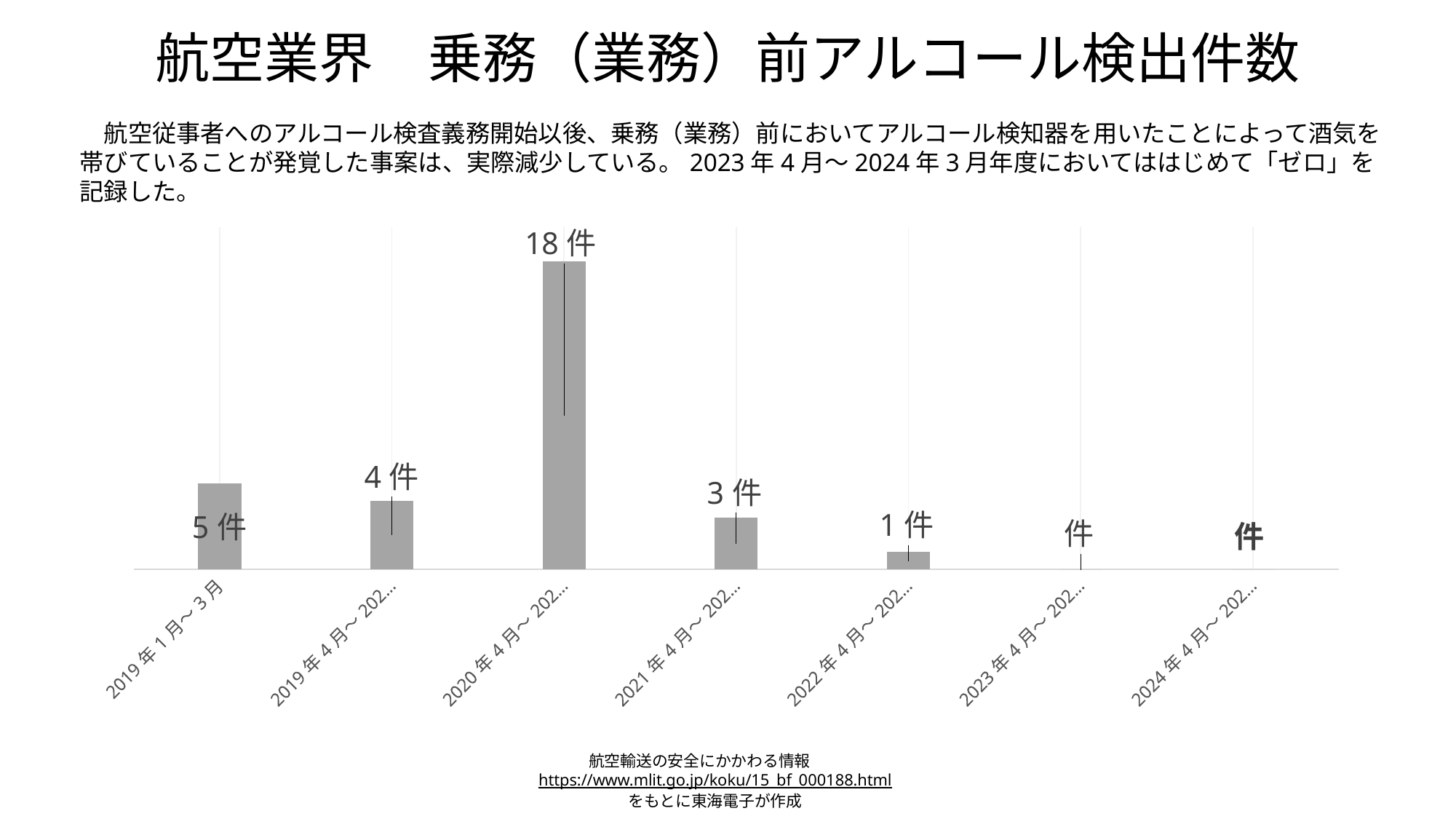
What is the value for the period starting 2020年4月? 18 件 What is the value for the period starting 2022年4月? 1 件 Which is larger: the value for 2019年1月～3月 or the value for the period starting 2019年4月? 2019年1月～3月 What is the difference between the value for the period starting 2020年4月 and the value for the period starting 2021年4月? 15 件 Do the values rise or fall from the period starting 2020年4月 to the period starting 2022年4月? fall What is the value for the period starting 2019年4月? 4 件 What is the value for 2019年1月～3月? 5 件 How many categories (periods) are shown on the x axis of the chart? 7 Which period has the highest value? 2020年4月～ What is the value for the period starting 2021年4月? 3 件 What is the title of the slide containing the chart? 航空業界 乗務（業務）前アルコール検出件数 What type of chart is shown on the slide? bar chart